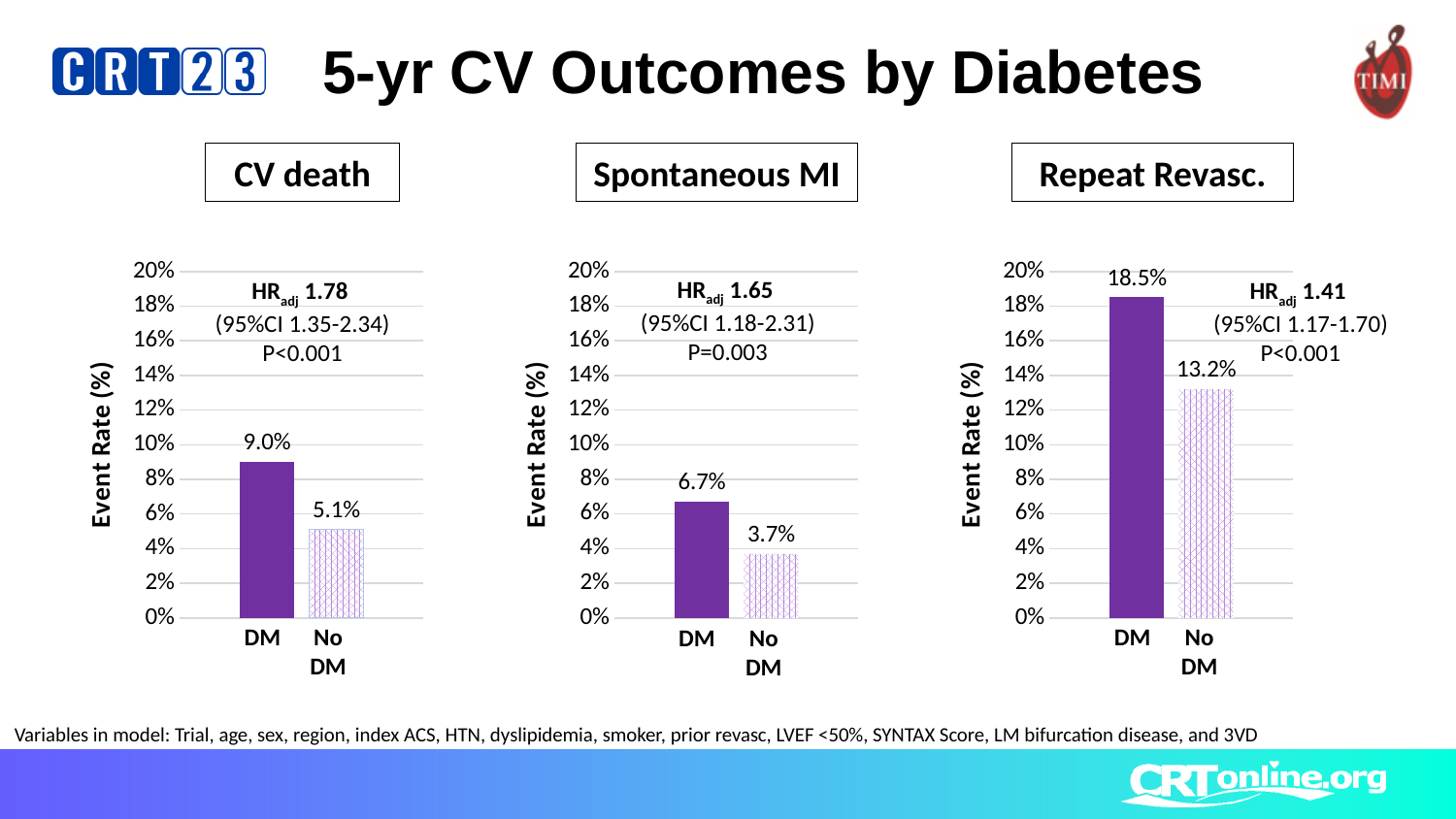
In the Spontaneous MI chart, what is the event rate for DM? 6.7% How many categories are shown on the x axis of the Spontaneous MI chart? 2 In the CV death chart, what is the difference in event rate between DM and No DM? 3.9% In the CV death chart, what is the event rate for DM? 9.0% What kind of chart is the CV death chart? Bar chart In the Repeat Revasc. chart, what is the difference in event rate between DM and No DM? 5.3% In the Repeat Revasc. chart, what is the event rate for No DM? 13.2% In the Repeat Revasc. chart, which group has the lowest event rate? No DM In the Spontaneous MI chart, what is the event rate for No DM? 3.7% In the Repeat Revasc. chart, what is the event rate for DM? 18.5% In the CV death chart, what is the event rate for No DM? 5.1% In the Spontaneous MI chart, which group has the higher event rate, DM or No DM? DM